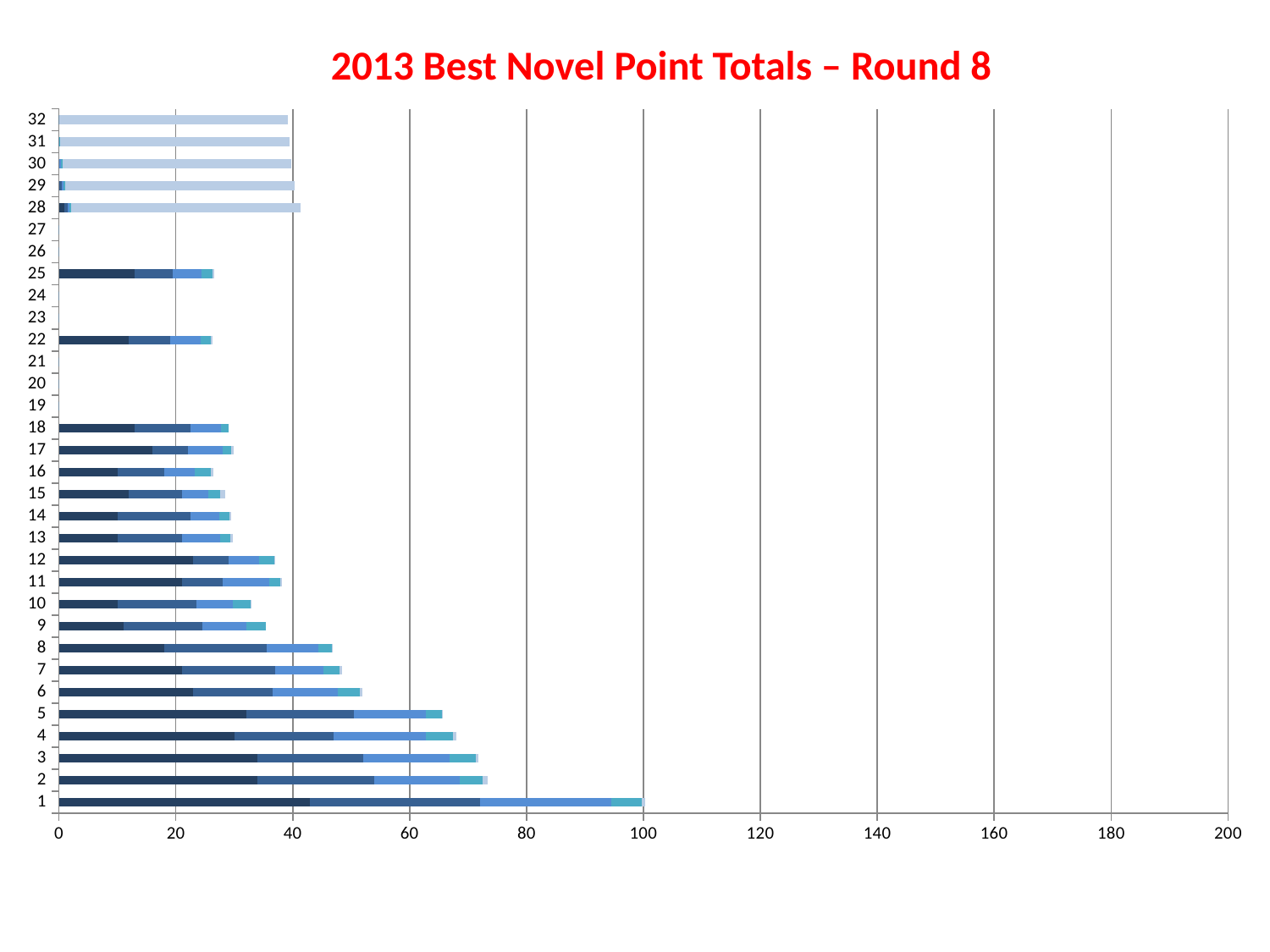
Is the total value for category 1 greater or less than 80? greater Is the total value for category 25 greater or less than 20? greater Is the total value for category 5 greater or less than 60? greater Which has the larger total, category 11 or category 10? 11 Which category has the longest bar in the chart? 1 How many categories are listed on the vertical axis of the chart? 32 What kind of chart is shown on the slide? Stacked horizontal bar chart What is the title of the chart? 2013 Best Novel Point Totals – Round 8 Which has the larger total, category 6 or category 8? 6 What is the highest value shown on the horizontal axis? 200